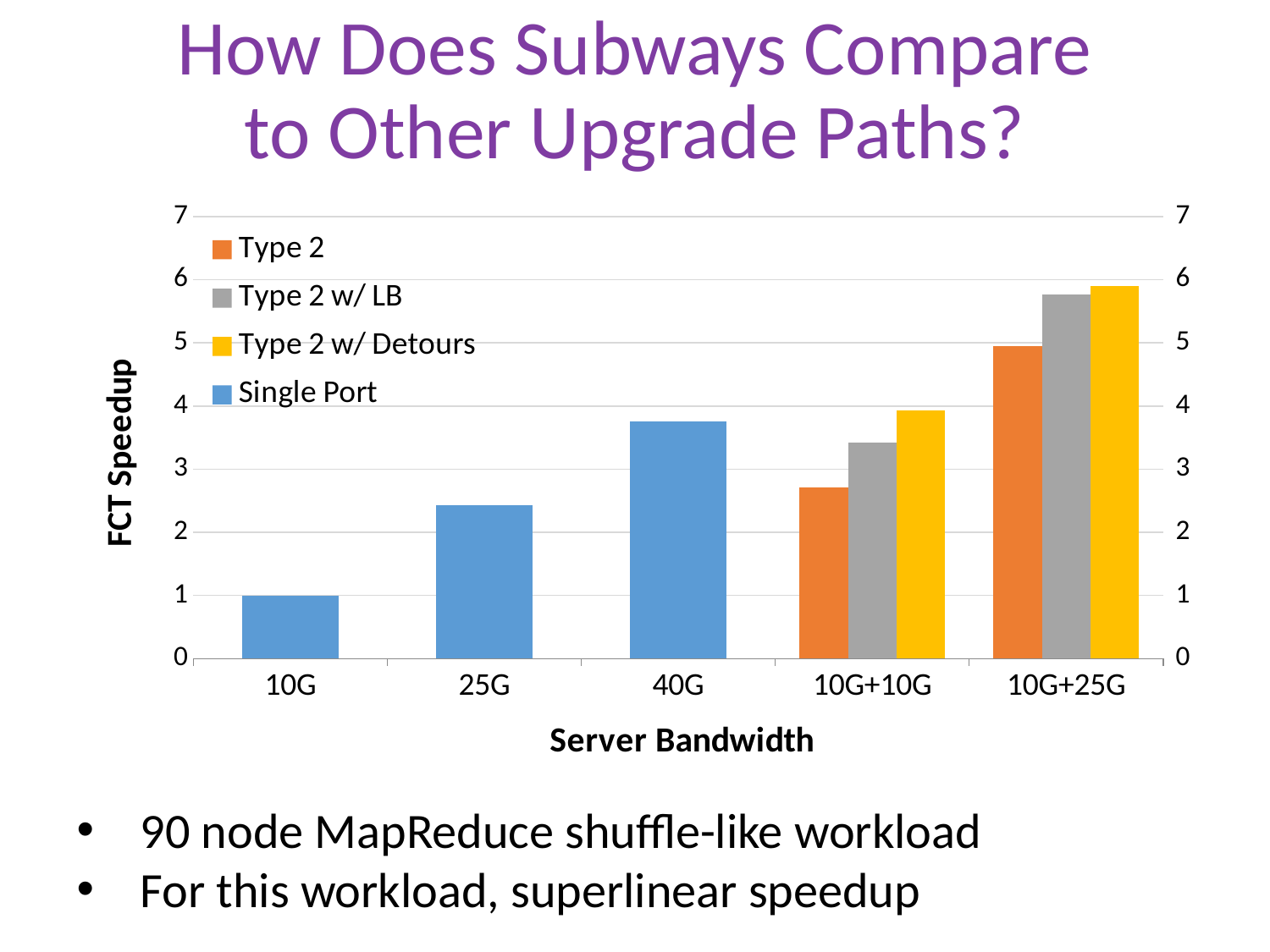
What is the FCT Speedup for Single Port at 10G? 1 At 10G+10G, which is larger: Type 2 or Type 2 w/ Detours? Type 2 w/ Detours What kind of chart is shown on the slide? bar chart How many server bandwidth categories are shown on the x axis? 5 Is the Single Port value at 40G greater or less than 3? greater Among the Single Port bars, which server bandwidth has the highest FCT Speedup? 40G Is the Single Port value at 25G greater or less than 2? greater Is the Type 2 value at 10G+10G greater or less than 3? less What is the title of the x axis? Server Bandwidth Do the Single Port values rise or fall from 10G to 40G? rise How many series does the legend list? 4